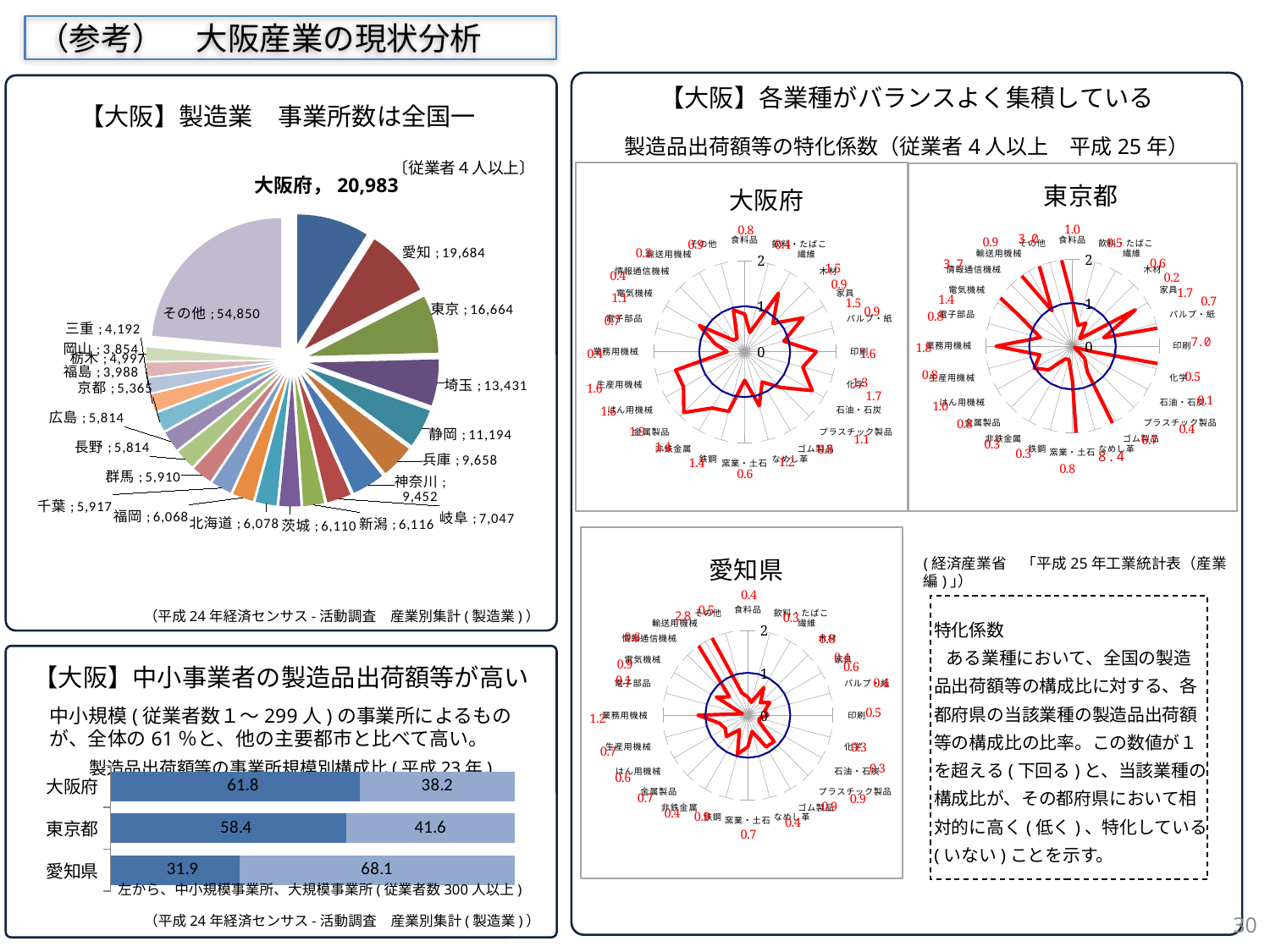
In the pie chart titled 【大阪】製造業 事業所数は全国一, what is the value for 愛知? 19,684 In the radar chart titled 東京都, what is the value for 印刷? 7.0 In the pie chart titled 【大阪】製造業 事業所数は全国一, what is the value for 大阪府? 20,983 In the pie chart titled 【大阪】製造業 事業所数は全国一, what is the value for 埼玉? 13,431 In the pie chart titled 【大阪】製造業 事業所数は全国一, which prefecture (excluding その他) has the largest value? 大阪府 In the stacked bar chart titled 製造品出荷額等の事業所規模別構成比, what is the total of the bar for 東京都? 100 In the pie chart titled 【大阪】製造業 事業所数は全国一, which is larger, 静岡 or 兵庫? 静岡 In the stacked bar chart titled 製造品出荷額等の事業所規模別構成比, what is the value of the second (right) segment for 愛知県? 68.1 In the stacked bar chart titled 製造品出荷額等の事業所規模別構成比, what is the value of the first (left) segment for 大阪府? 61.8 In the stacked bar chart titled 製造品出荷額等の事業所規模別構成比, how many categories are shown? 3 In the radar chart titled 愛知県, what is the value for 輸送用機械? 2.8 In the pie chart titled 【大阪】製造業 事業所数は全国一, what is the difference between 大阪府 and 東京? 4,319